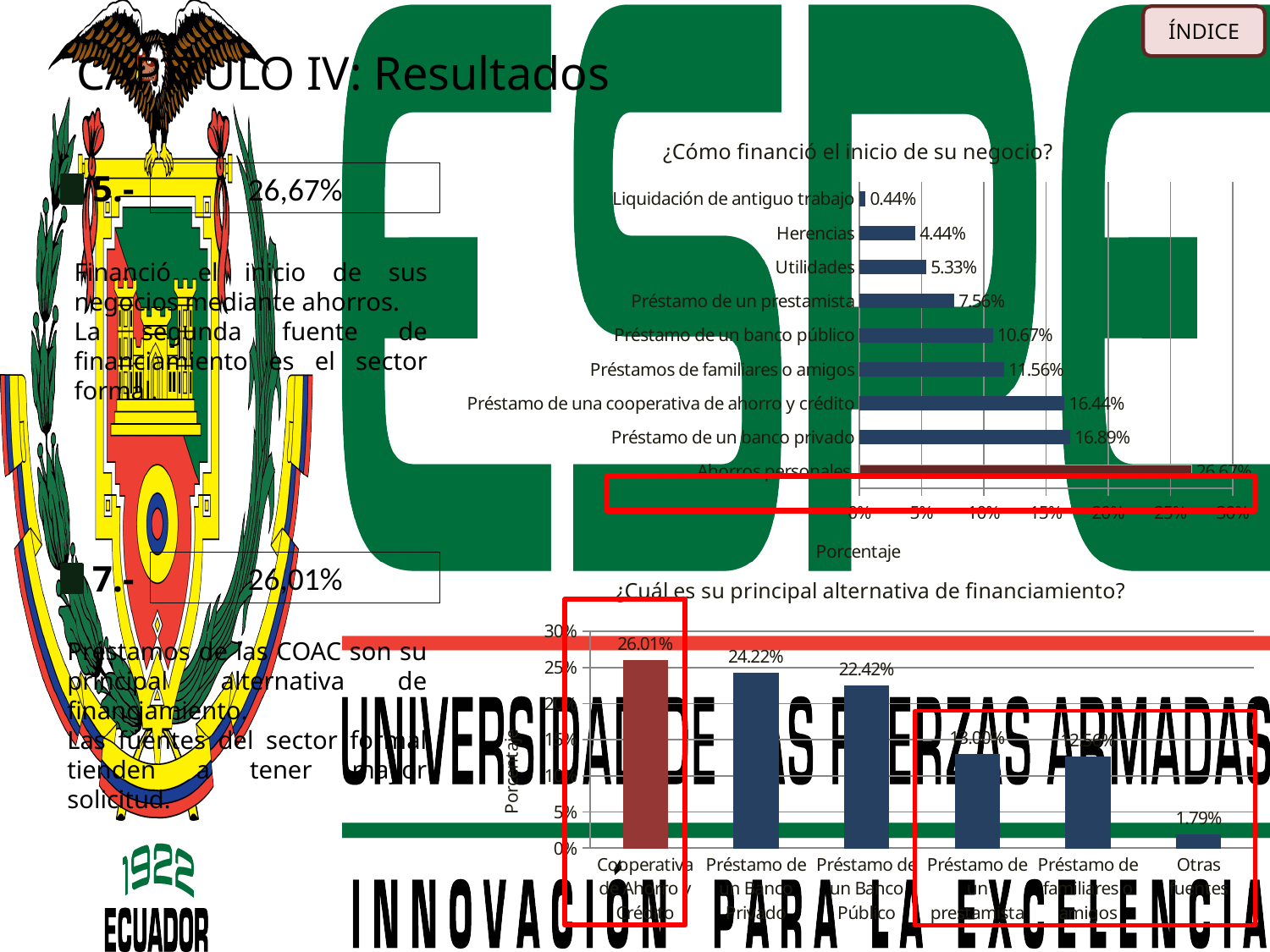
What kind of chart is '¿Cuál es su principal alternativa de financiamiento?'? Bar chart In the chart titled '¿Cuál es su principal alternativa de financiamiento?', is the value for Préstamo de un prestamista greater or less than 20%? less In the chart titled '¿Cómo financió el inicio de su negocio?', which is larger: Utilidades or Préstamo de un prestamista? Préstamo de un prestamista How many categories are shown in the chart titled '¿Cómo financió el inicio de su negocio?'? 9 In the chart titled '¿Cuál es su principal alternativa de financiamiento?', what is the value for Otras fuentes? 1.79% In the chart titled '¿Cómo financió el inicio de su negocio?', which category has the lowest value? Liquidación de antiguo trabajo In the chart titled '¿Cómo financió el inicio de su negocio?', what is the difference between Préstamos de familiares o amigos and Préstamo de un banco público? 0.89% In the chart titled '¿Cuál es su principal alternativa de financiamiento?', what is the value for Cooperativa de Ahorro y Crédito? 26.01% In the chart titled '¿Cuál es su principal alternativa de financiamiento?', what is the difference between Préstamo de un Banco Privado and Préstamo de un Banco Público? 1.80% In the chart titled '¿Cómo financió el inicio de su negocio?', which category has the highest value? Ahorros personales In the chart titled '¿Cómo financió el inicio de su negocio?', what is the value for Herencias? 4.44% In the chart titled '¿Cómo financió el inicio de su negocio?', what is the value for Préstamo de un banco privado? 16.89%